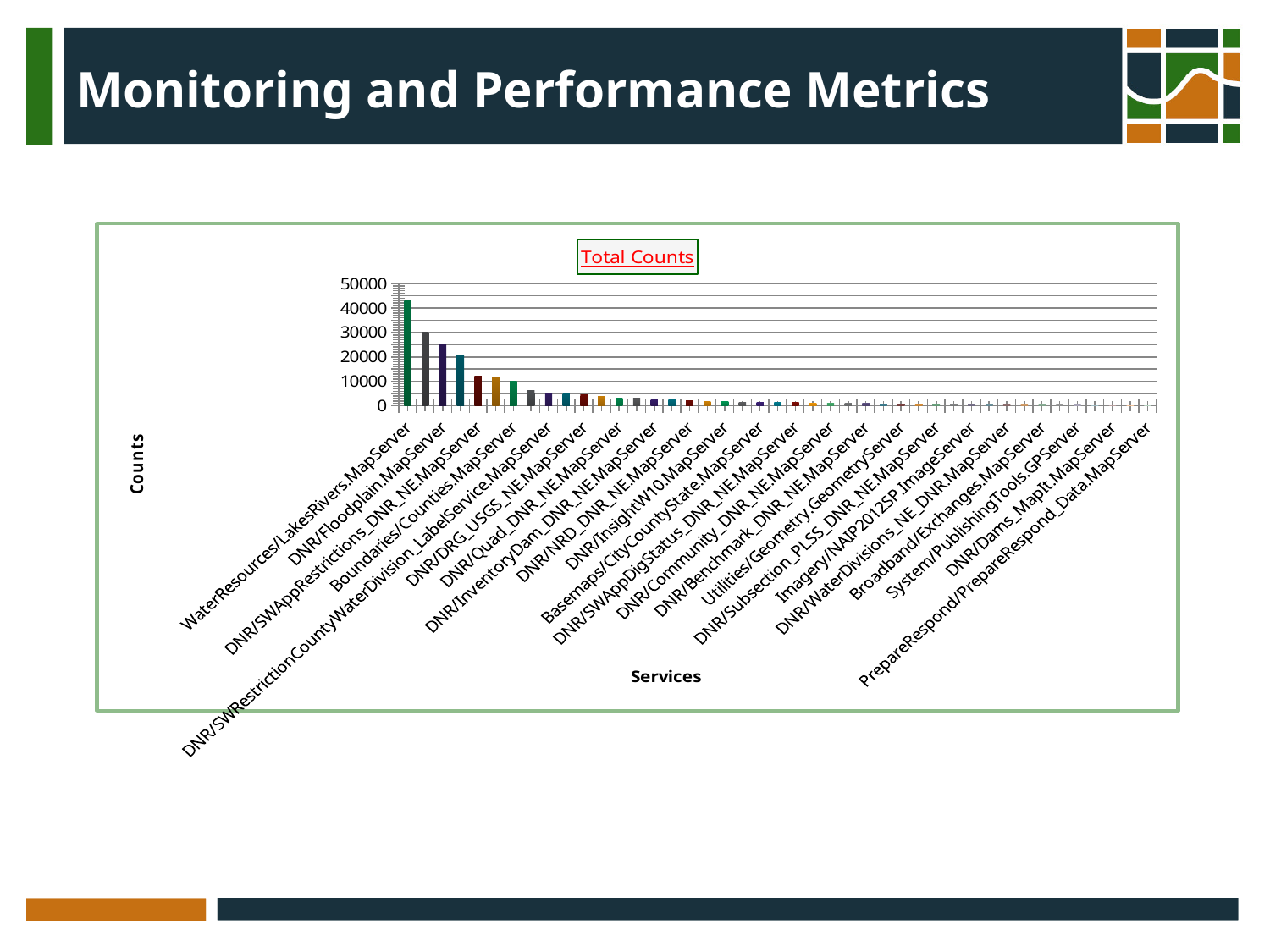
Which has a larger value, WaterResources/LakesRivers.MapServer or PrepareRespond/PrepareRespond_Data.MapServer? WaterResources/LakesRivers.MapServer What kind of chart is shown on the slide? bar chart Do the values rise or fall moving from left to right along the x axis? fall Is the value for WaterResources/LakesRivers.MapServer greater or less than 30000? greater What is the highest tick value shown on the vertical axis? 50000 What is the title of the chart? Total Counts What is the label on the vertical axis of the chart? Counts Is the value for PrepareRespond/PrepareRespond_Data.MapServer greater or less than 10000? less Is the value for WaterResources/LakesRivers.MapServer greater or less than 40000? greater Which service has the highest total count? WaterResources/LakesRivers.MapServer